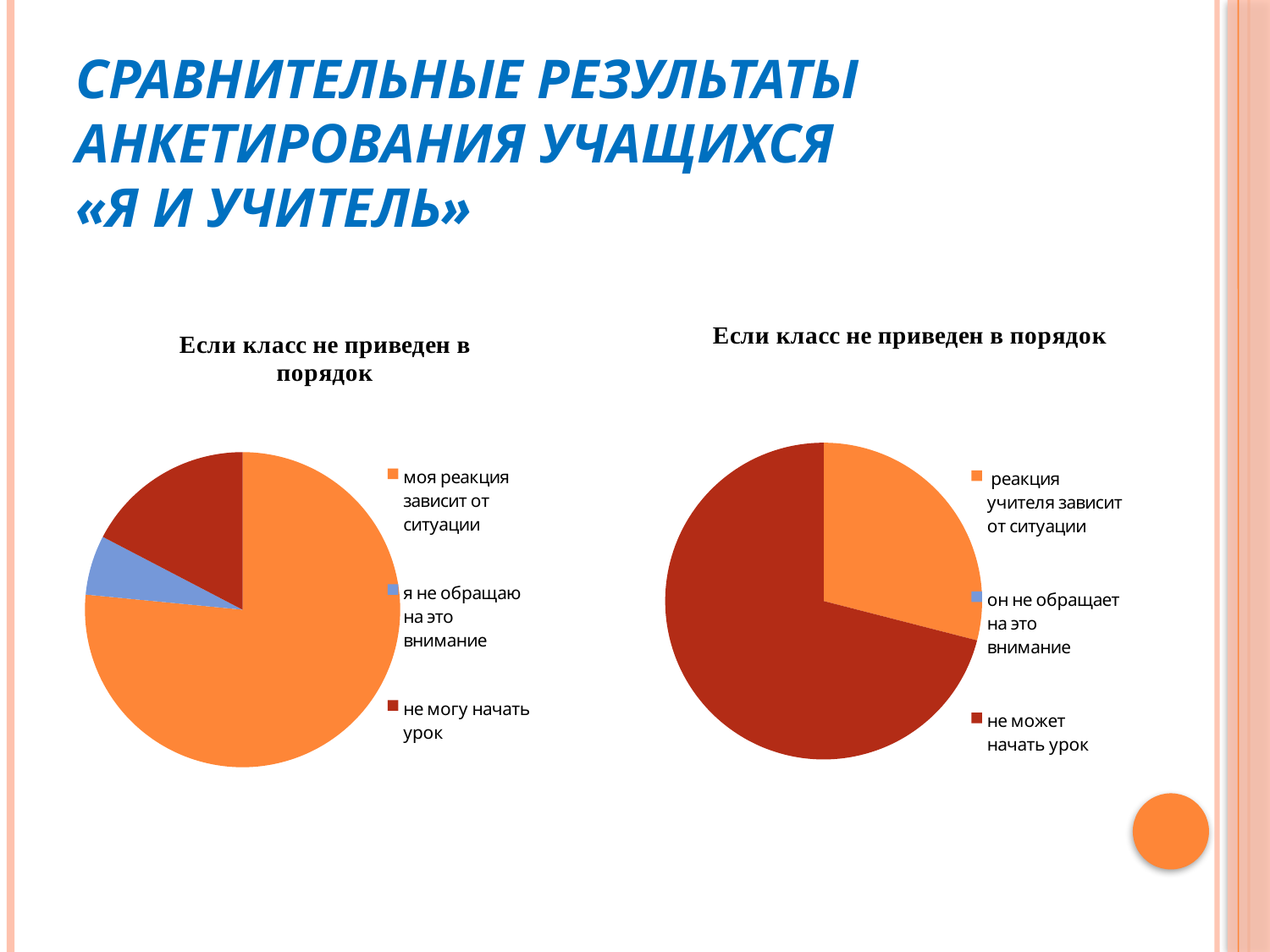
In the left pie chart, what colour is the slice for "я не обращаю на это внимание"? blue What kind of chart is the right chart on the slide? pie chart How many entries does the legend of the right pie chart list? 3 What kind of chart is the left chart on the slide? pie chart How many entries does the legend of the left pie chart list? 3 In the left pie chart, which category has the largest slice? моя реакция зависит от ситуации In the left pie chart, which slice is larger: "не могу начать урок" or "я не обращаю на это внимание"? не могу начать урок In the left pie chart, which category has the smallest slice? я не обращаю на это внимание In the right pie chart, which category has the largest slice? не может начать урок In the right pie chart, which slice is larger: "реакция учителя зависит от ситуации" or "не может начать урок"? не может начать урок What is the title of the right pie chart? Если класс не приведен в порядок